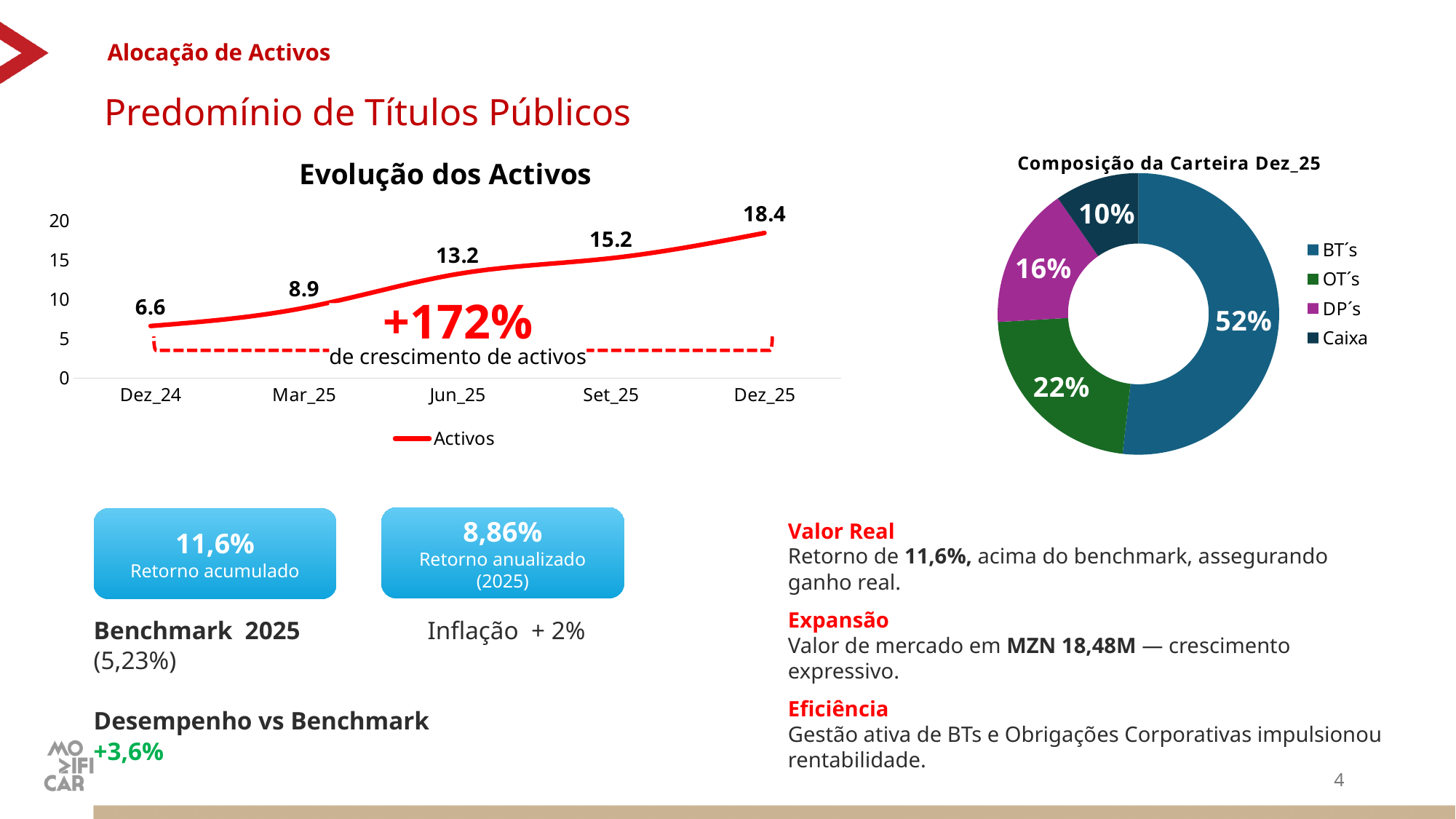
In the 'Evolução dos Activos' chart, what is the value for Jun_25? 13.2 In the 'Evolução dos Activos' chart, what is the value for Dez_24? 6.6 What kind of chart is 'Evolução dos Activos'? line chart In the 'Evolução dos Activos' chart, do the values rise or fall from Dez_24 to Dez_25? rise In the 'Evolução dos Activos' chart, how many periods are plotted on the x axis? 5 In the 'Composição da Carteira Dez_25' chart, which category has the smallest share? Caixa How many categories does the legend of the 'Composição da Carteira Dez_25' chart list? 4 In the 'Composição da Carteira Dez_25' chart, what share does OT´s have? 22% In the 'Evolução dos Activos' chart, what is the difference between the Dez_25 and Dez_24 values? 11.8 What is the name of the series shown in the legend of the 'Evolução dos Activos' chart? Activos In the 'Evolução dos Activos' chart, which period has the highest value? Dez_25 In the 'Composição da Carteira Dez_25' chart, which is larger, DP´s or OT´s? OT´s